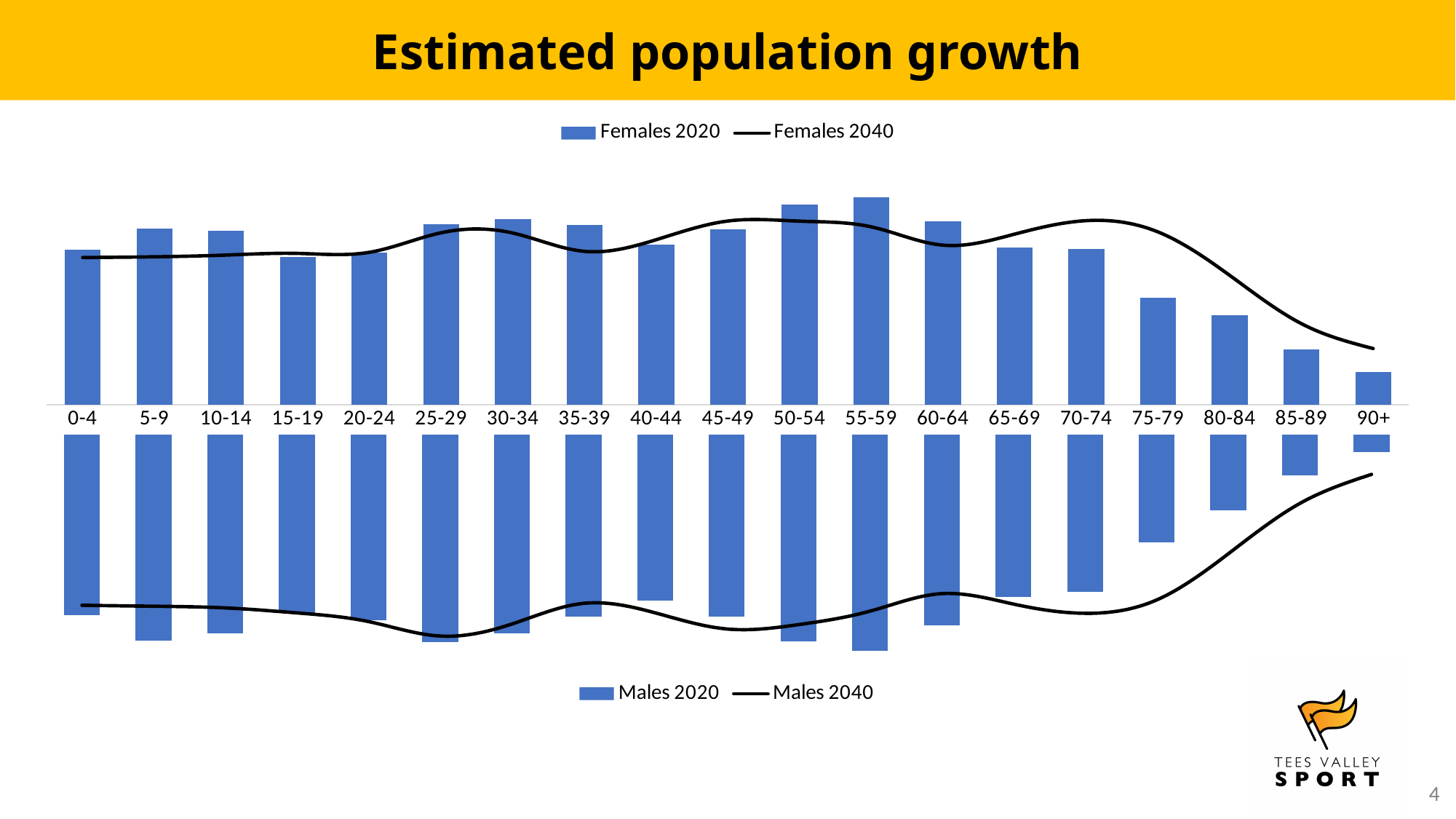
In the top chart (Females), is the Females 2020 bar larger for 75-79 or for 80-84? 75-79 In the bottom chart (Males), is the Males 2020 bar larger for 65-69 or for 75-79? 65-69 How many age groups are shown along the x axis of the top chart (Females)? 19 In the top chart (Females), which age group has the tallest Females 2020 bar? 55-59 How many series does the legend of the top chart (Females) list? 2 In the top chart (Females), which age group has the shortest Females 2020 bar? 90+ What are the two legend entries of the bottom chart (Males)? Males 2020 and Males 2040 In the bottom chart (Males), which age group has the longest Males 2020 bar? 55-59 In the bottom chart (Males), which age group has the shortest Males 2020 bar? 90+ In the top chart (Females), do the Females 2020 bars rise or fall from 65-69 to 90+? Fall What kind of chart is used for the Females 2020 series in the top chart? Bar chart How many series does the legend of the bottom chart (Males) list? 2